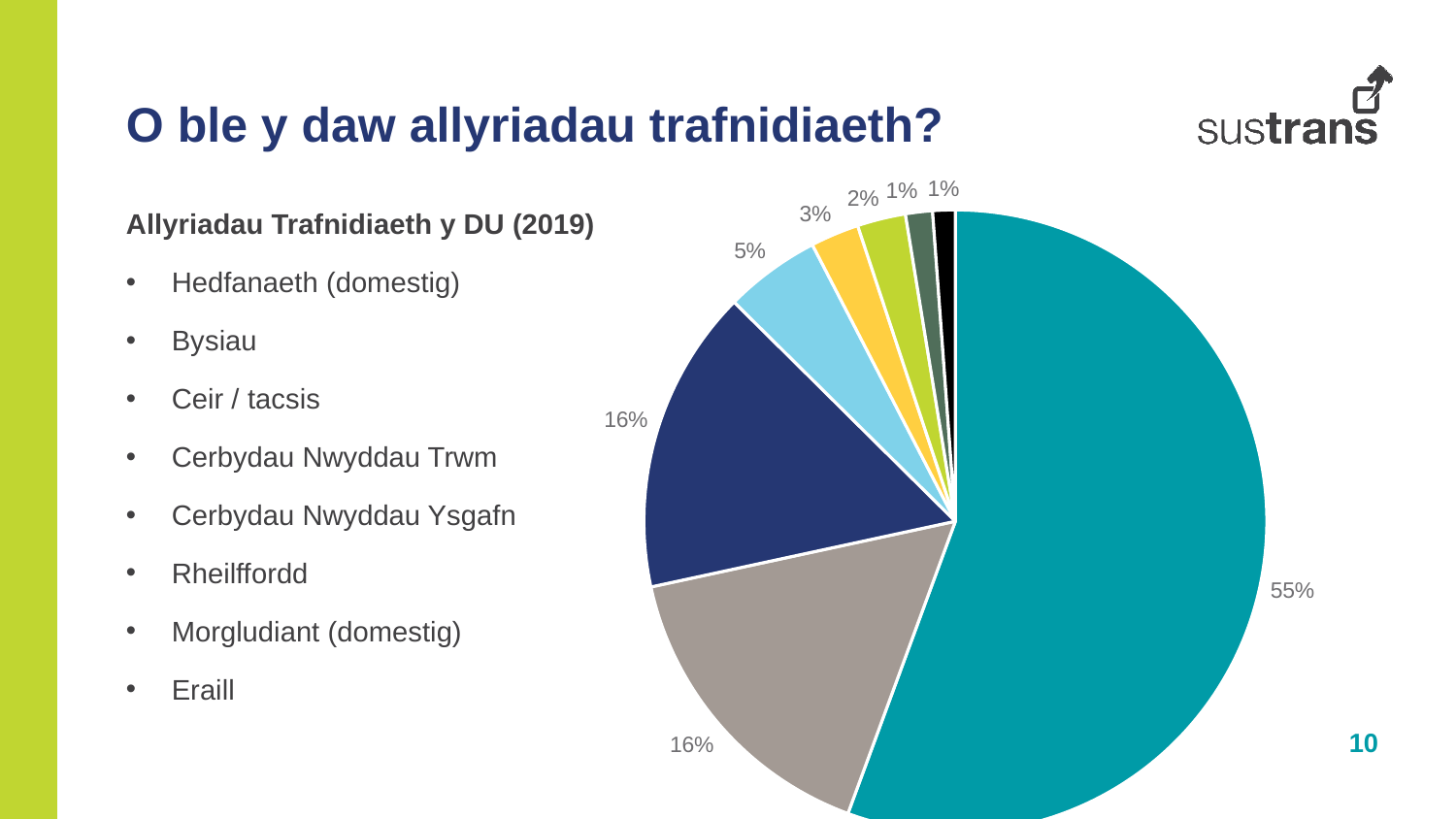
What is the value of the smallest slice in the pie chart? 1% Does the largest slice of the pie chart account for more or less than half of the total? More What is the difference in percentage points between the largest slice (55%) and a 16% slice? 39 percentage points How many slices in the pie chart are labelled 16%? 2 What colour is the largest slice of the pie chart? Teal What is the combined share of the two slices labelled 16%? 32% How many slices in the pie chart are labelled 1%? 2 How many slices does the pie chart have? 8 What is the difference in percentage points between the 5% slice and the 3% slice? 2 percentage points Which year do the UK transport emissions on the slide refer to? 2019 What is the value of the largest slice in the pie chart? 55% What kind of chart is shown on the slide? Pie chart